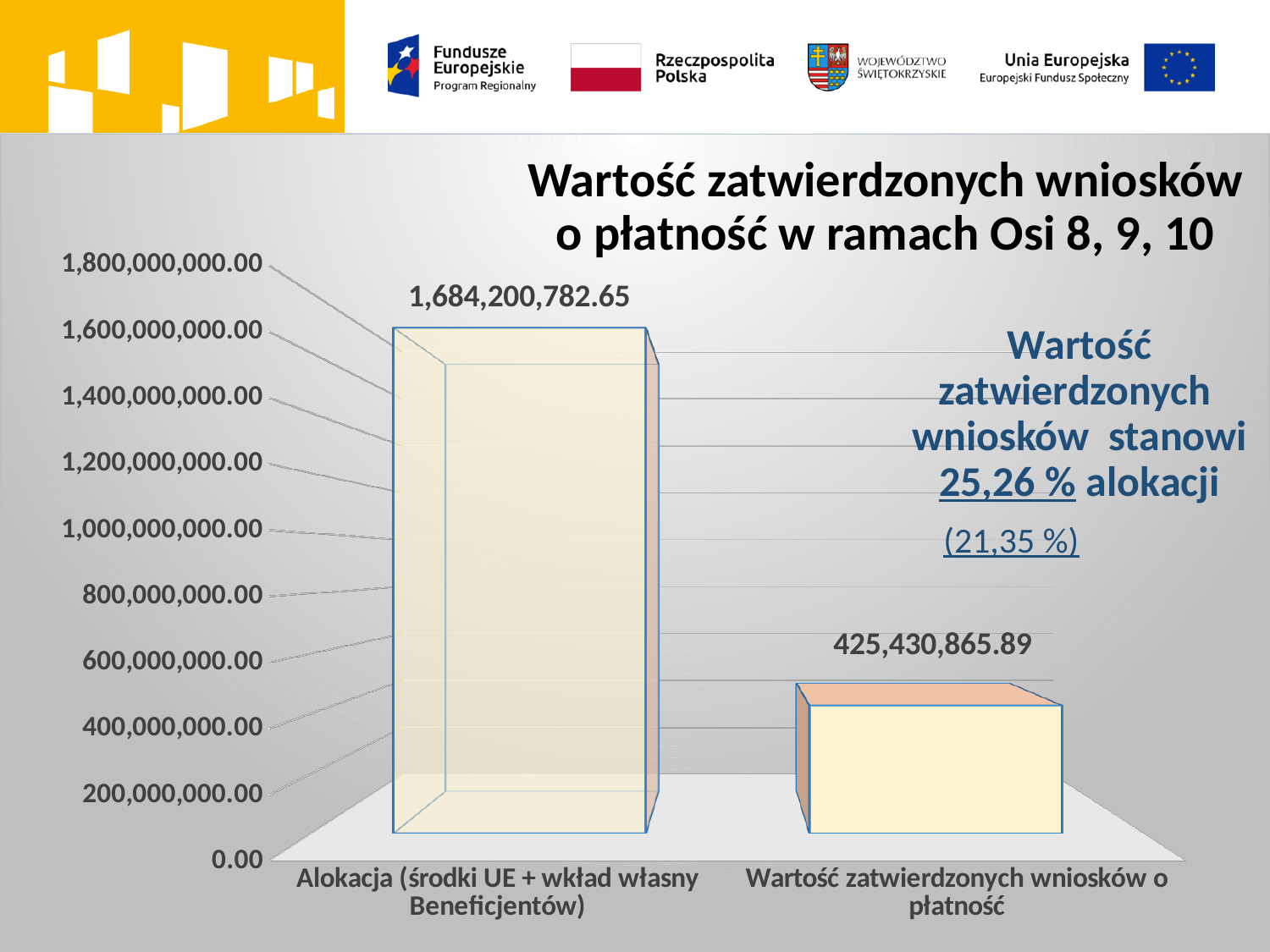
What is the value for "Alokacja (środki UE + wkład własny Beneficjentów)"? 1,684,200,782.65 What kind of chart is shown on the slide? bar chart Which category has the lowest value? Wartość zatwierdzonych wniosków o płatność Which category has the highest value? Alokacja (środki UE + wkład własny Beneficjentów) What is the value for "Wartość zatwierdzonych wniosków o płatność"? 425,430,865.89 Which is larger: the value for "Alokacja (środki UE + wkład własny Beneficjentów)" or the value for "Wartość zatwierdzonych wniosków o płatność"? Alokacja (środki UE + wkład własny Beneficjentów) What is the difference between the value for "Alokacja (środki UE + wkład własny Beneficjentów)" and the value for "Wartość zatwierdzonych wniosków o płatność"? 1,258,769,916.76 Is the value for "Wartość zatwierdzonych wniosków o płatność" greater or less than 600,000,000.00? less How many categories are shown in the chart? 2 Is the value for "Alokacja (środki UE + wkład własny Beneficjentów)" greater or less than 1,600,000,000.00? greater According to the text on the slide, what percentage of the allocation does the value of approved payment applications represent? 25,26 % What is the title of the chart? Wartość zatwierdzonych wniosków o płatność w ramach Osi 8, 9, 10